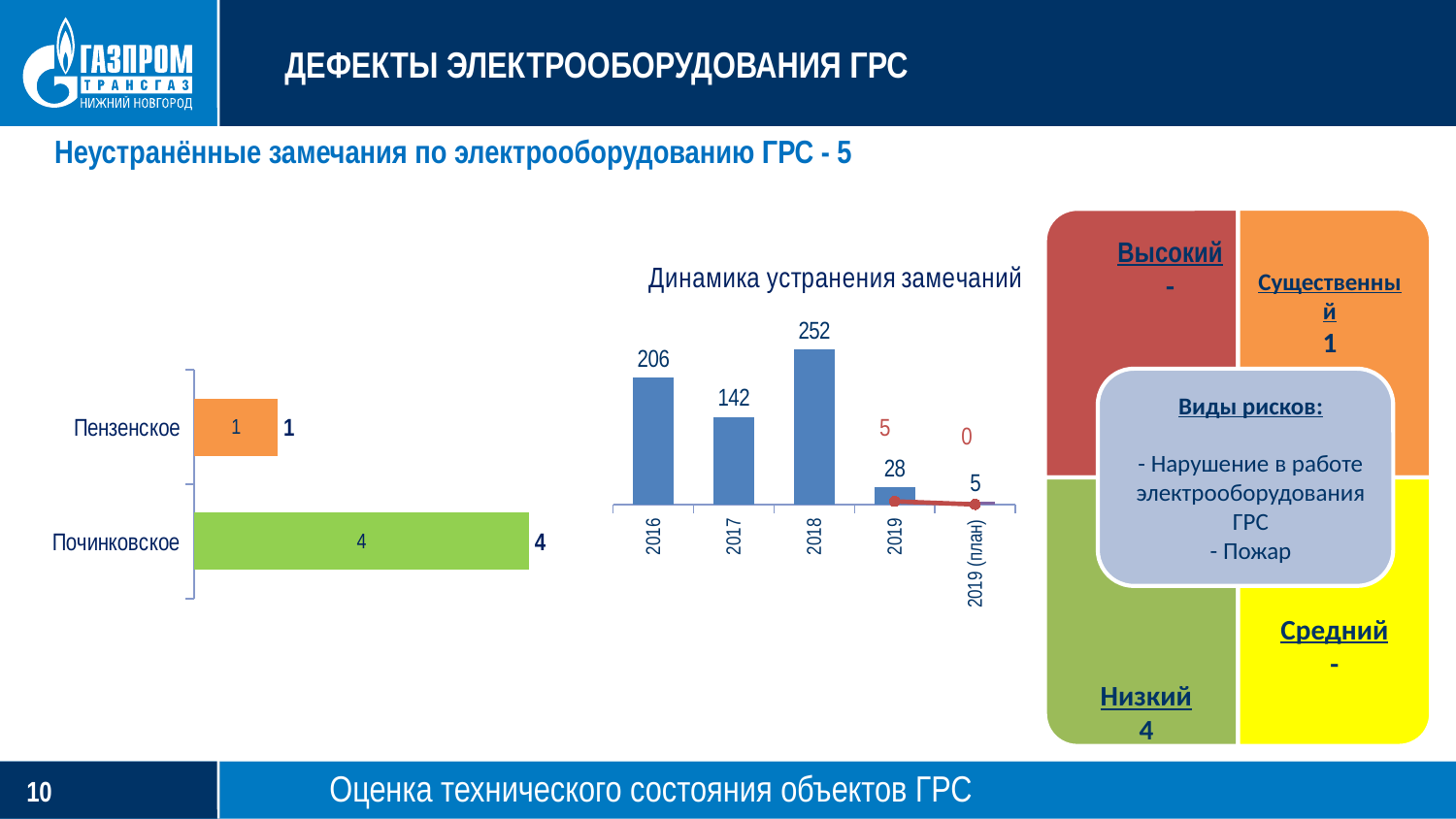
In the chart titled 'Динамика устранения замечаний', how many categories are shown on the x axis? 5 In the horizontal bar chart on the left, what is the value for Починковское? 4 In the chart titled 'Динамика устранения замечаний', what is the bar value for 2018? 252 In the chart titled 'Динамика устранения замечаний', which year has the highest bar? 2018 In the chart titled 'Динамика устранения замечаний', what is the difference between the bar values for 2018 and 2016? 46 In the chart titled 'Динамика устранения замечаний', do the bar values rise or fall from 2018 to 2019 (план)? fall In the chart titled 'Динамика устранения замечаний', which category has the lowest bar? 2019 (план) In the chart titled 'Динамика устранения замечаний', what is the bar value for 2017? 142 What kind of chart is the chart on the left of the slide? bar chart In the chart titled 'Динамика устранения замечаний', which bar is larger: 2016 or 2017? 2016 In the chart titled 'Динамика устранения замечаний', what is the red line value labelled for 2019 (план)? 0 In the horizontal bar chart on the left, which category has the higher value: Пензенское or Починковское? Починковское